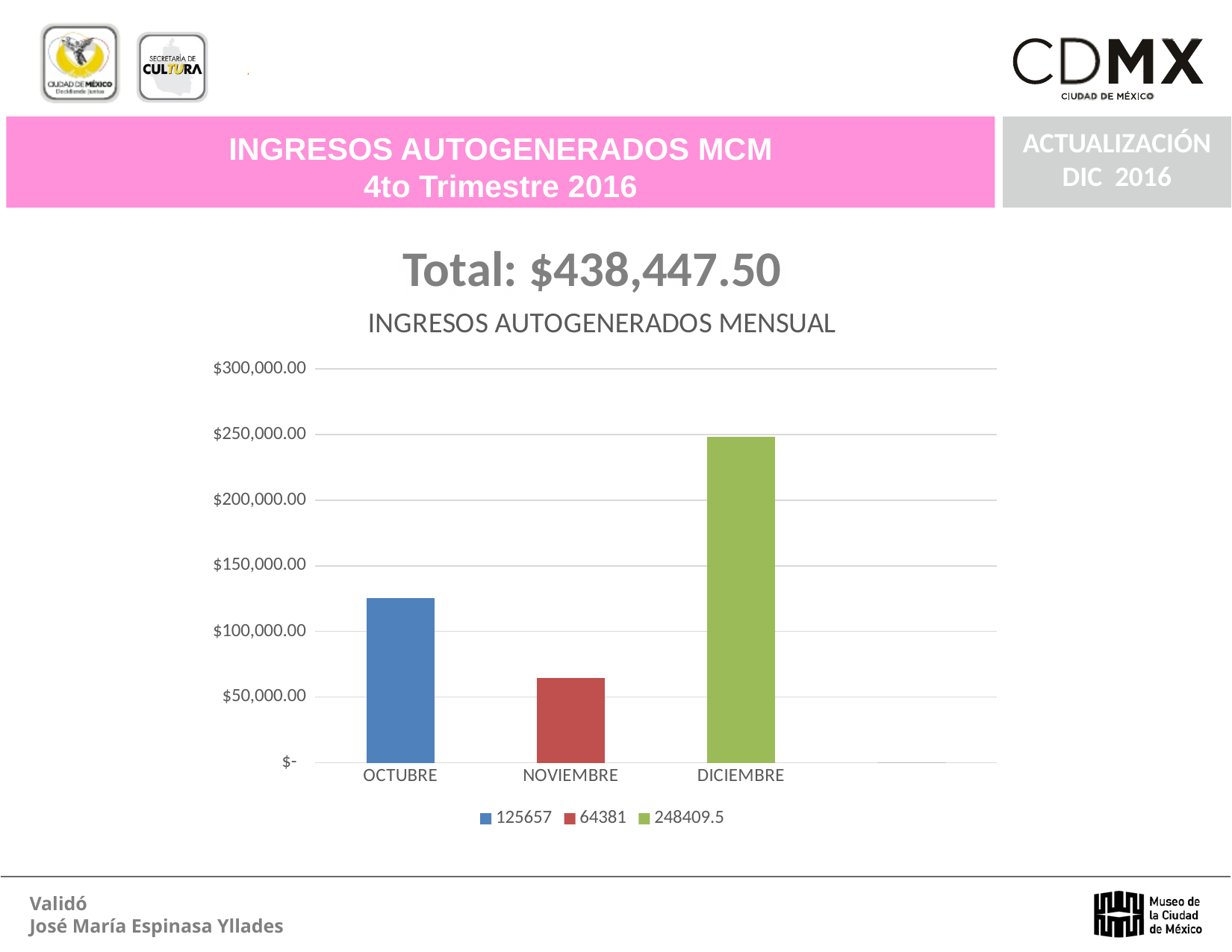
Which month has the highest bar in the chart? DICIEMBRE What total is stated above the chart? $438,447.50 Which legend entry is shown with the green colour? 248409.5 Is the value for NOVIEMBRE greater or less than $100,000.00? less How many months are shown on the x axis of the chart? 3 How many entries does the chart's legend list? 3 Is the value for OCTUBRE greater or less than $100,000.00? greater Which month has the lowest bar in the chart? NOVIEMBRE Is the value for DICIEMBRE greater or less than $200,000.00? greater What is the title of the chart? INGRESOS AUTOGENERADOS MENSUAL What kind of chart is shown on the slide? bar chart Which is larger, the bar for OCTUBRE or the bar for NOVIEMBRE? OCTUBRE